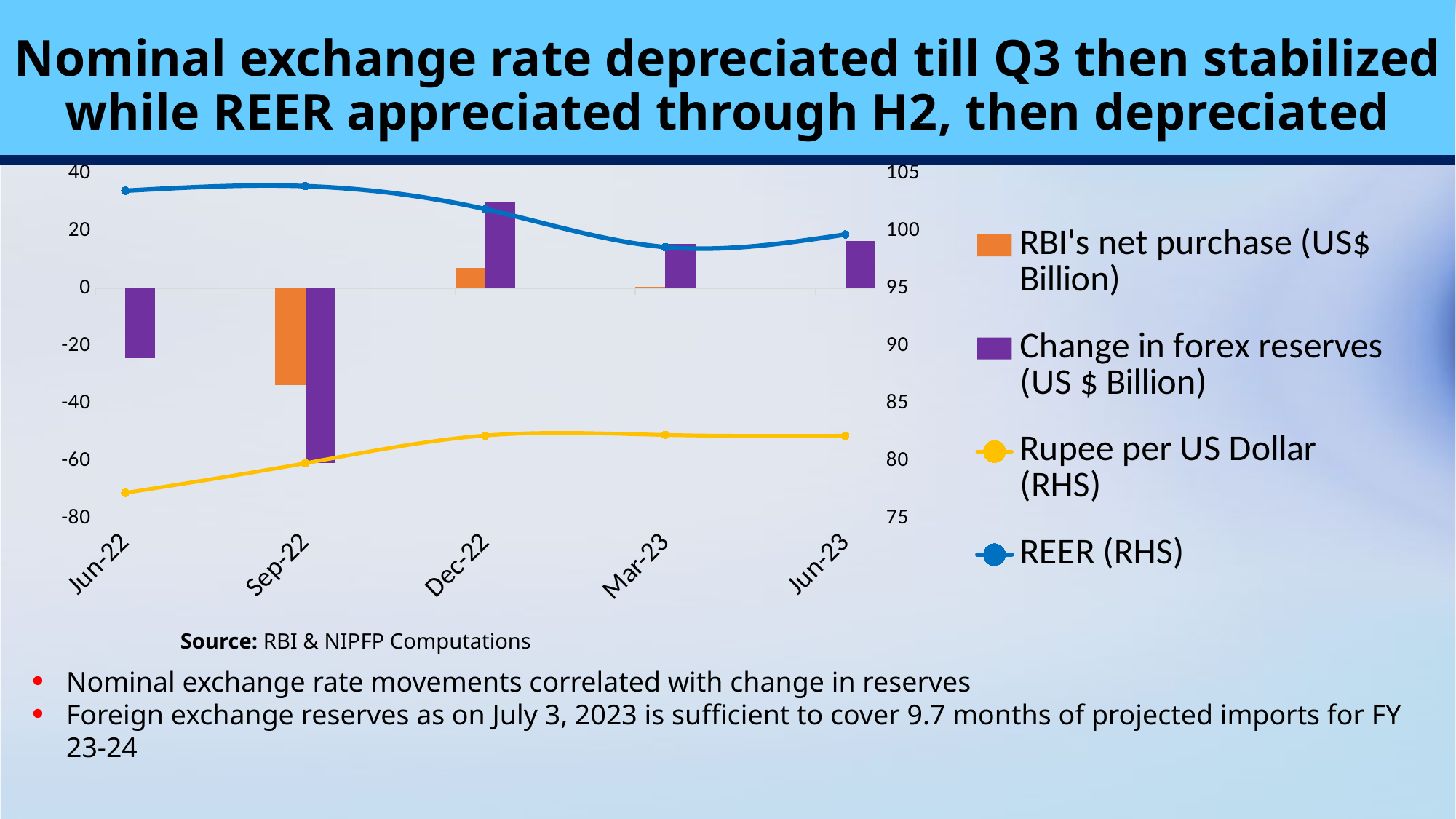
How many time periods are shown on the x axis? 5 Which series is shown in orange in the legend? RBI's net purchase (US$ Billion) Is the Change in forex reserves for Sep-22 greater or less than -40? less Is RBI's net purchase for Sep-22 greater or less than -20? less In which period is the Change in forex reserves lowest? Sep-22 Is the Rupee per US Dollar (RHS) value for Jun-22 greater or less than 80? less What kind of chart is shown on the slide? A combination bar and line chart Does the Rupee per US Dollar line rise or fall from Jun-22 to Dec-22? rise In which period is the Change in forex reserves highest? Dec-22 How many series does the legend list? 4